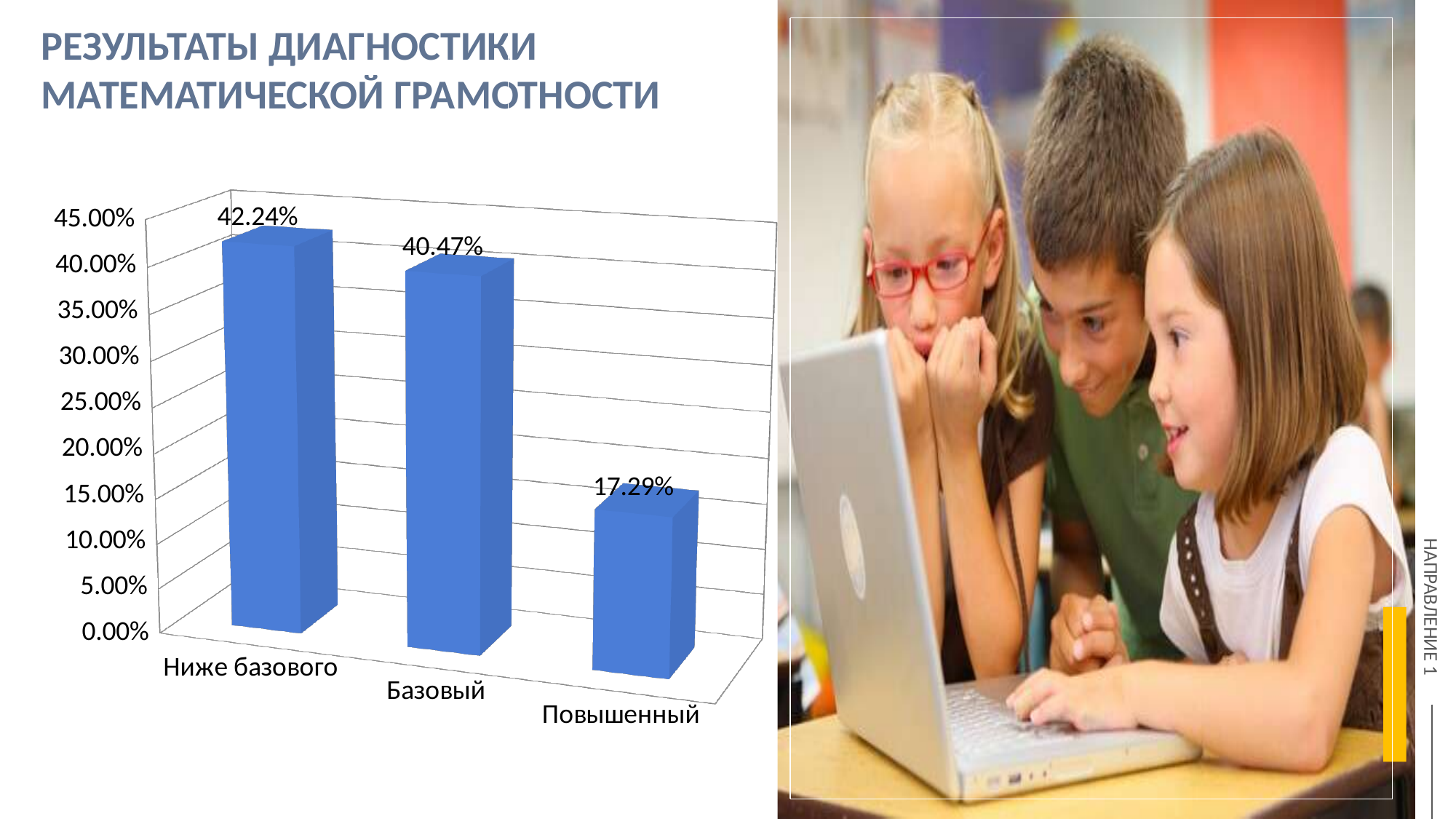
Which category has the lowest value? Повышенный What is the value for Повышенный? 17.29% How many categories are shown on the chart? 3 Which is larger, the value for Базовый or the value for Повышенный? Базовый What kind of chart is shown on the slide? bar chart Which category has the highest value? Ниже базового Is the value for Повышенный greater or less than 20.00%? less Do the values rise or fall from left to right along the x axis? fall What is the value for Ниже базового? 42.24% What is the difference between the values for Ниже базового and Повышенный? 24.95% What is the value for Базовый? 40.47% What is the difference between the values for Базовый and Повышенный? 23.18%